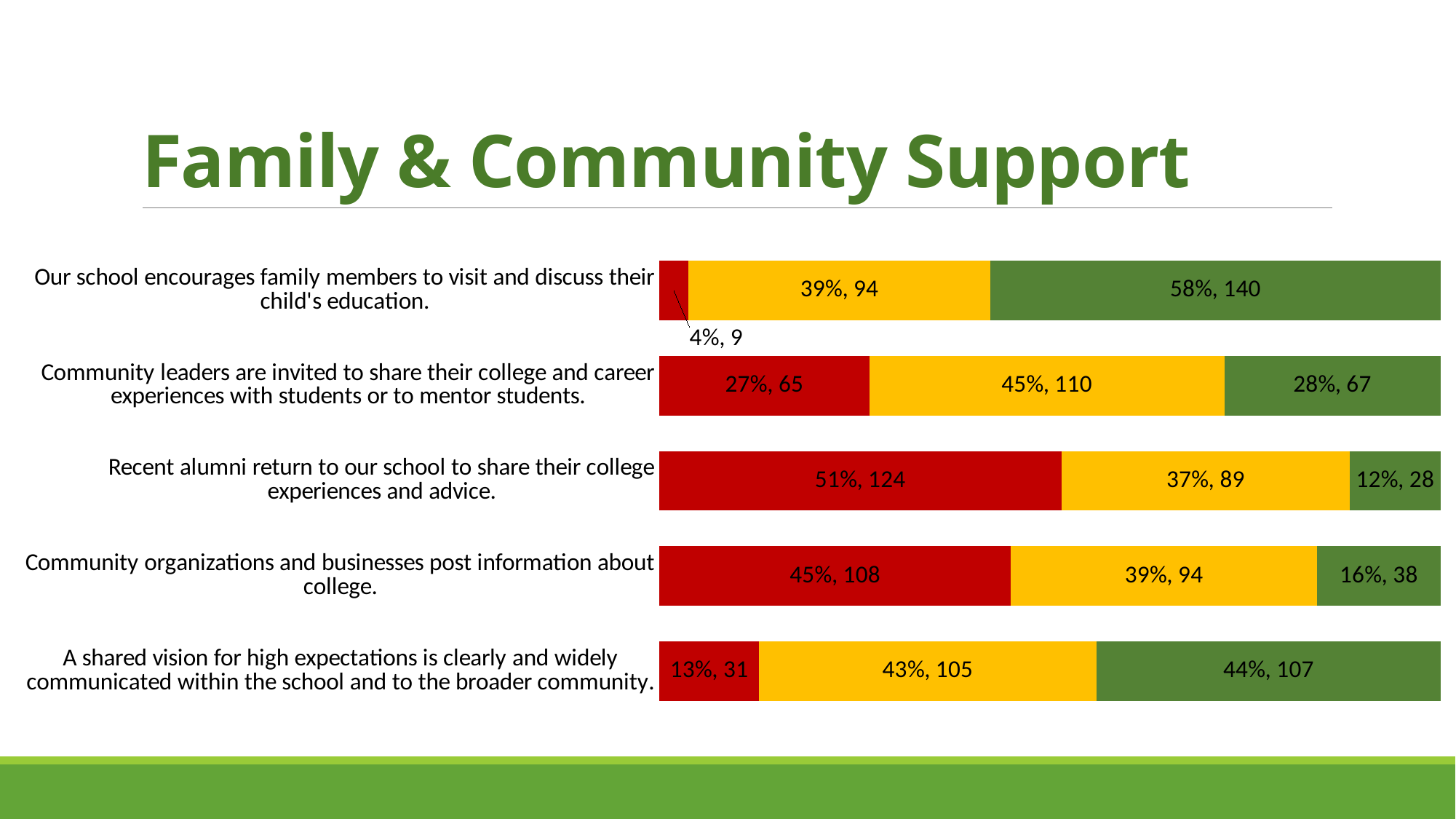
What is the data label on the yellow segment of the bar for "Community leaders are invited to share their college and career experiences with students or to mentor students."? 45%, 110 How many categories (bars) are shown in the chart? 5 For "A shared vision for high expectations is clearly and widely communicated within the school and to the broader community.", what is the difference in count between the green segment (107) and the red segment (31)? 76 What is the data label on the red segment of the bar for "Recent alumni return to our school to share their college experiences and advice."? 51%, 124 What is the title of the slide? Family & Community Support What kind of chart is shown on the slide? Stacked bar chart Which category has the largest green segment? Our school encourages family members to visit and discuss their child's education. What is the data label on the green segment of the bar for "Community organizations and businesses post information about college."? 16%, 38 Which has the larger red segment: "Recent alumni return to our school to share their college experiences and advice." or "Community organizations and businesses post information about college."? Recent alumni return to our school to share their college experiences and advice. Which category has the smallest red segment? Our school encourages family members to visit and discuss their child's education. What is the total count across all three segments of the bar for "Community leaders are invited to share their college and career experiences with students or to mentor students."? 242 What is the data label on the green segment of the bar for "Our school encourages family members to visit and discuss their child's education."? 58%, 140